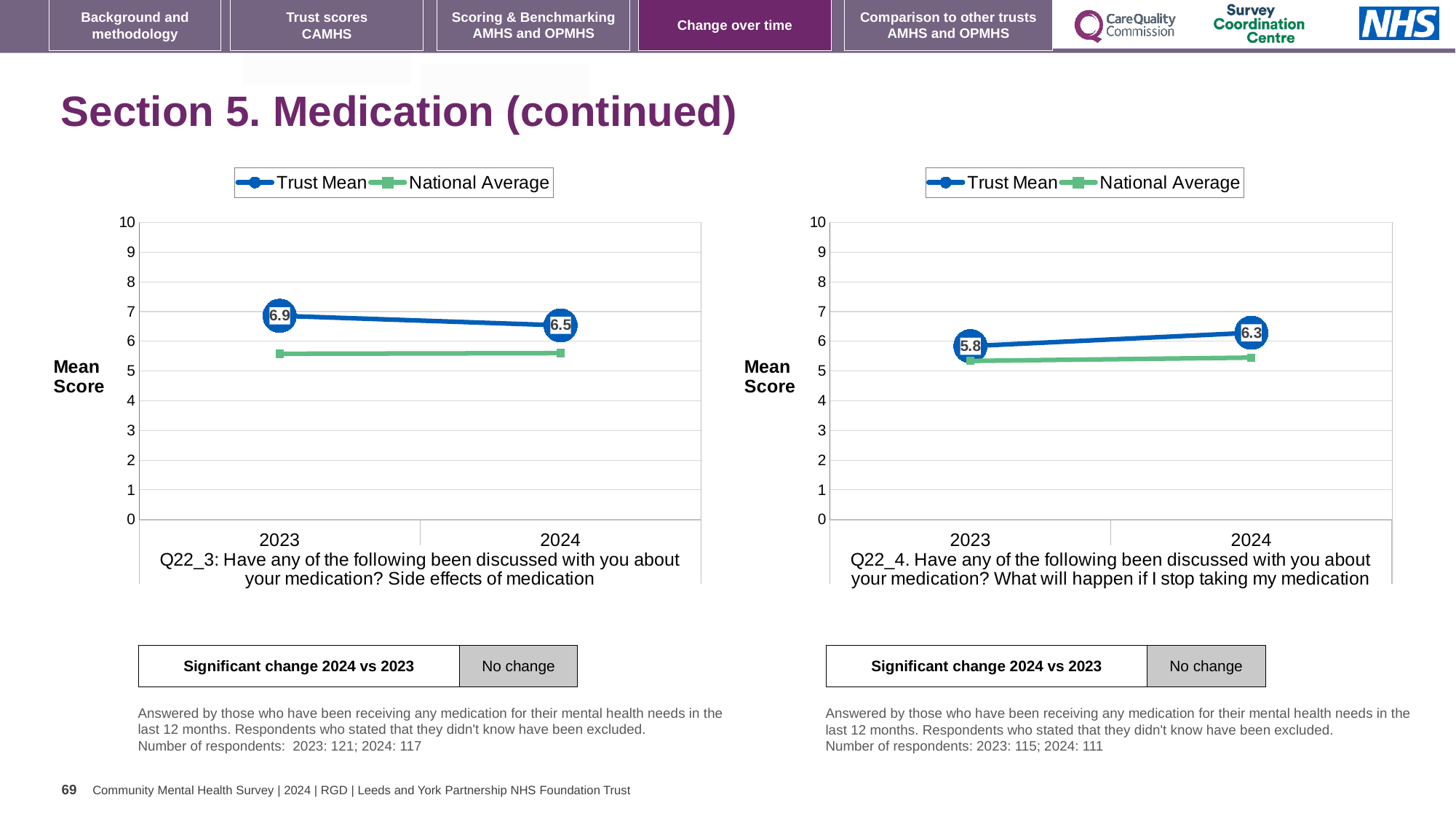
In the right chart (Q22_4), which is higher in 2024, the Trust Mean or the National Average? Trust Mean In the left chart (Q22_3), what is the Trust Mean for 2024? 6.5 In the right chart (Q22_4), does the Trust Mean rise or fall from 2023 to 2024? rise What type of chart is used for Q22_4 on the right? line chart How many series does the legend of the left chart (Q22_3) list? 2 In the right chart (Q22_4), what is the Trust Mean for 2024? 6.3 In the right chart (Q22_4), what is the Trust Mean for 2023? 5.8 In the left chart (Q22_3), does the Trust Mean rise or fall from 2023 to 2024? fall In the left chart (Q22_3), is the National Average for 2023 greater or less than 6? less In the left chart (Q22_3), what is the Trust Mean for 2023? 6.9 In the right chart (Q22_4), what is the difference between the Trust Mean in 2024 and 2023? 0.5 In the left chart (Q22_3), by how much did the Trust Mean change from 2023 to 2024? 0.4